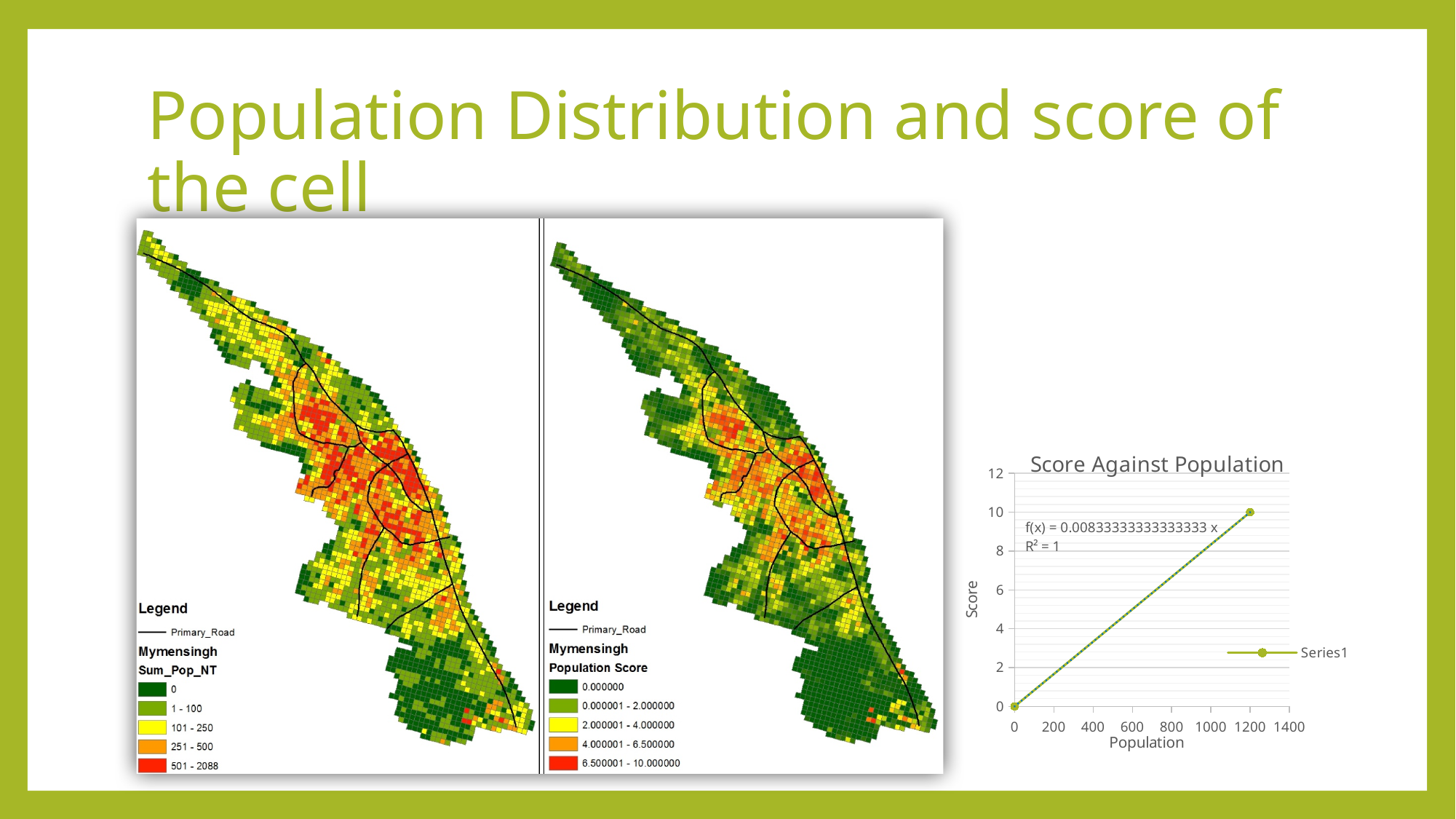
In the 'Score Against Population' chart, how many series does the legend list? 1 In the 'Score Against Population' chart, does the score rise or fall as population increases? rise In the 'Score Against Population' chart, what is the highest value shown on the x axis? 1400 In the 'Score Against Population' chart, what is the trendline equation shown? f(x) = 0.00833333333333333 x What is the title of the chart on the right side of the slide? Score Against Population In the 'Score Against Population' chart, what is the name of the series in the legend? Series1 In the 'Score Against Population' chart, what is the score when the population is 1200? 10 In the 'Score Against Population' chart, what kind of chart is shown? scatter chart In the 'Score Against Population' chart, what is the score when the population is 0? 0 In the 'Score Against Population' chart, is the score at a population of 1200 greater or less than 8? greater In the 'Score Against Population' chart, how many data points are plotted? 2 In the 'Score Against Population' chart, what is the R² value shown for the trendline? R² = 1